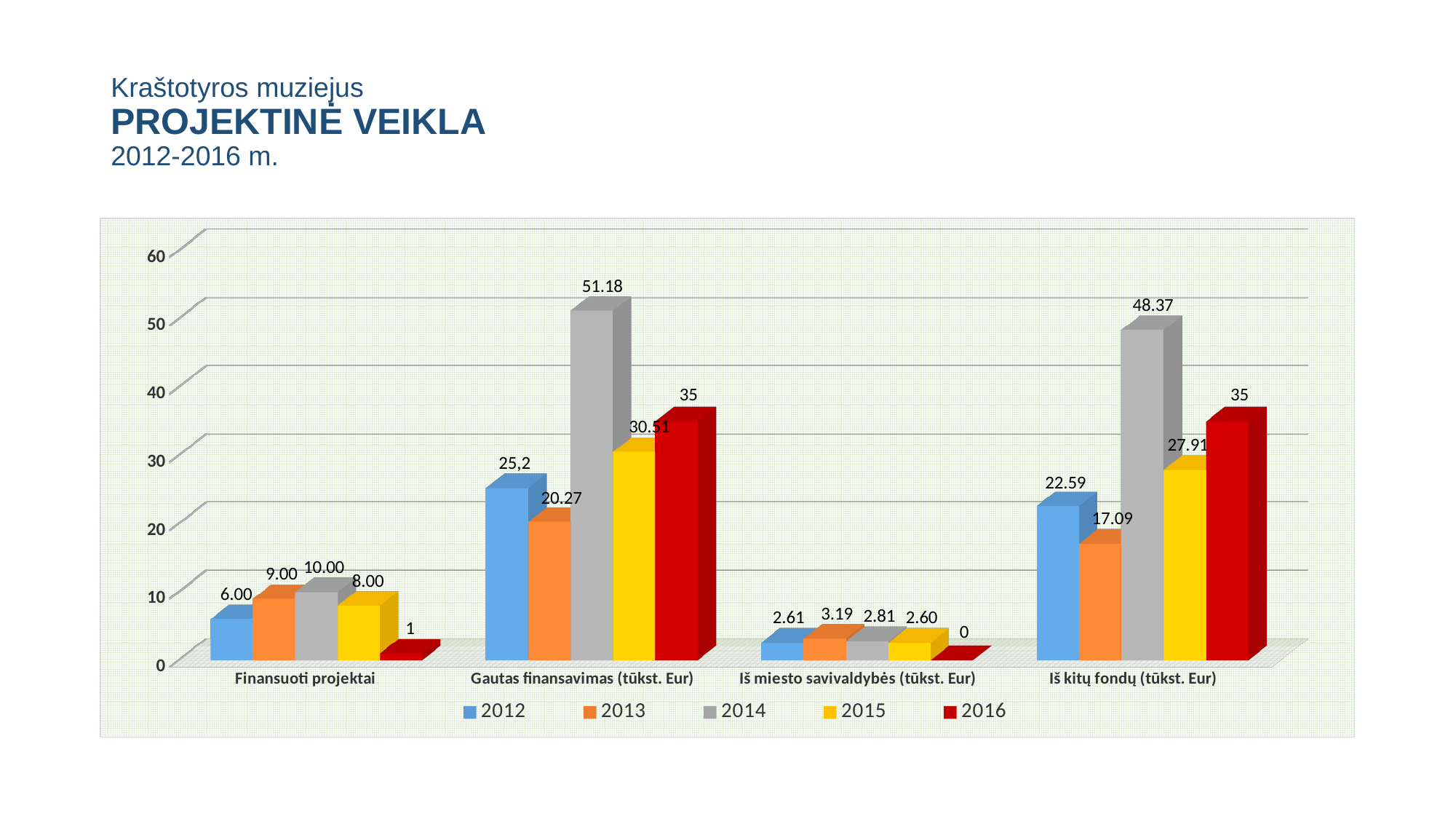
Which year has the highest value in the category "Finansuoti projektai"? 2014 How many series does the legend list? 5 Which colour represents the 2016 series in the legend? red How many categories are shown on the x axis? 4 Which year has the lowest value in the category "Gautas finansavimas (tūkst. Eur)"? 2013 What kind of chart is shown on the slide? bar chart What is the value for 2013 in the category "Iš kitų fondų (tūkst. Eur)"? 17.09 What is the value for 2016 in the category "Iš miesto savivaldybės (tūkst. Eur)"? 0 Is the value for 2014 in the category "Iš kitų fondų (tūkst. Eur)" greater or less than 40? greater What is the difference between the 2014 and 2016 values in the category "Iš kitų fondų (tūkst. Eur)"? 13.37 What is the value for 2014 in the category "Gautas finansavimas (tūkst. Eur)"? 51.18 Which is larger in the category "Gautas finansavimas (tūkst. Eur)": the value for 2015 or the value for 2016? 2016